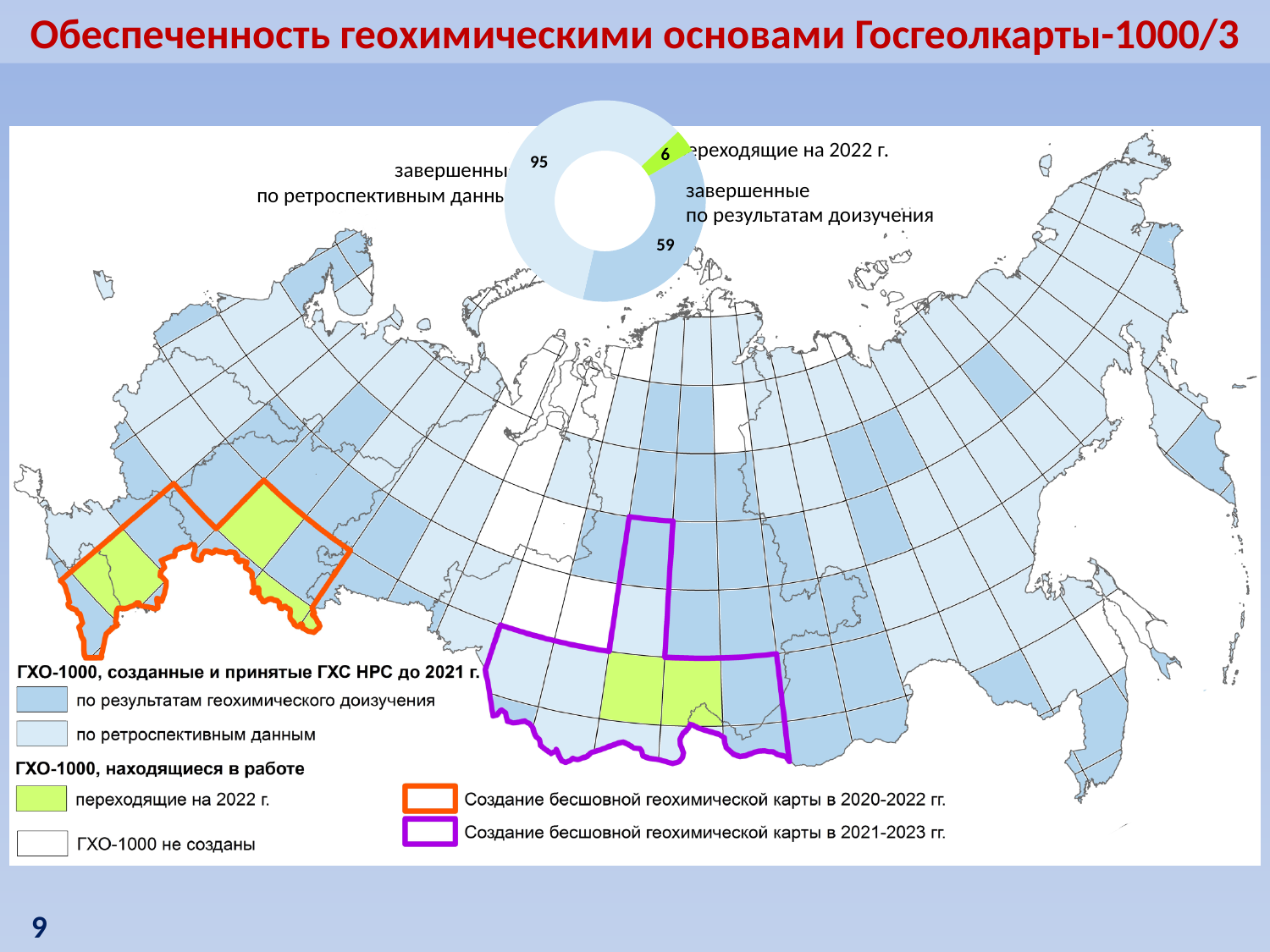
What colour is the slice 'переходящие на 2022 г.' in the donut chart? Green What is the value for the slice 'завершенные по результатам доизучения'? 59 What kind of chart is shown on the slide? Donut (pie) chart Which slice of the donut chart has the largest value? завершенные по ретроспективным данным Which is larger: the value for 'завершенные по результатам доизучения' or for 'переходящие на 2022 г.'? завершенные по результатам доизучения What share of the total does the slice 'переходящие на 2022 г.' represent? 3.75% What is the difference between the values for 'завершенные по ретроспективным данным' and 'завершенные по результатам доизучения'? 36 What is the value for the slice 'завершенные по ретроспективным данным'? 95 What is the total of all three values in the donut chart? 160 How many slices does the donut chart have? 3 What is the value for the slice 'переходящие на 2022 г.'? 6 Which slice of the donut chart has the smallest value? переходящие на 2022 г.